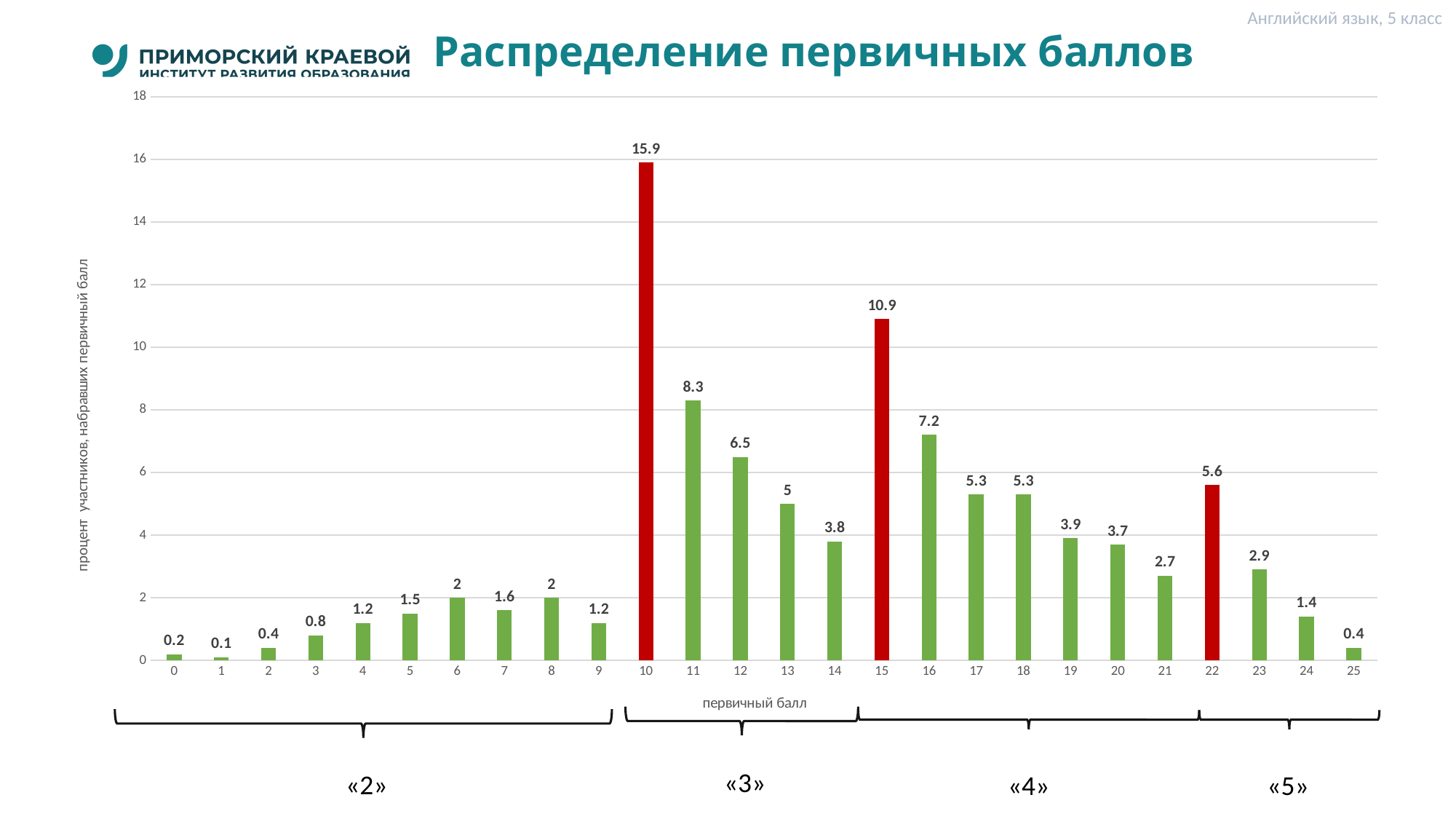
Which primary scores are shown with red bars? 10, 15 and 22 What type of chart is shown on the slide? bar chart Which primary score has the lowest value? 1 How many primary score categories are plotted on the x axis? 26 What is the value for primary score 15? 10.9 Is the value for primary score 12 greater or less than 6? greater Which primary score has the highest value? 10 What is the value for primary score 22? 5.6 What is the difference between the values for primary scores 10 and 15? 5 Which is larger, the value for primary score 11 or for primary score 16? 11 What is the value for primary score 3? 0.8 What is the value for primary score 10? 15.9